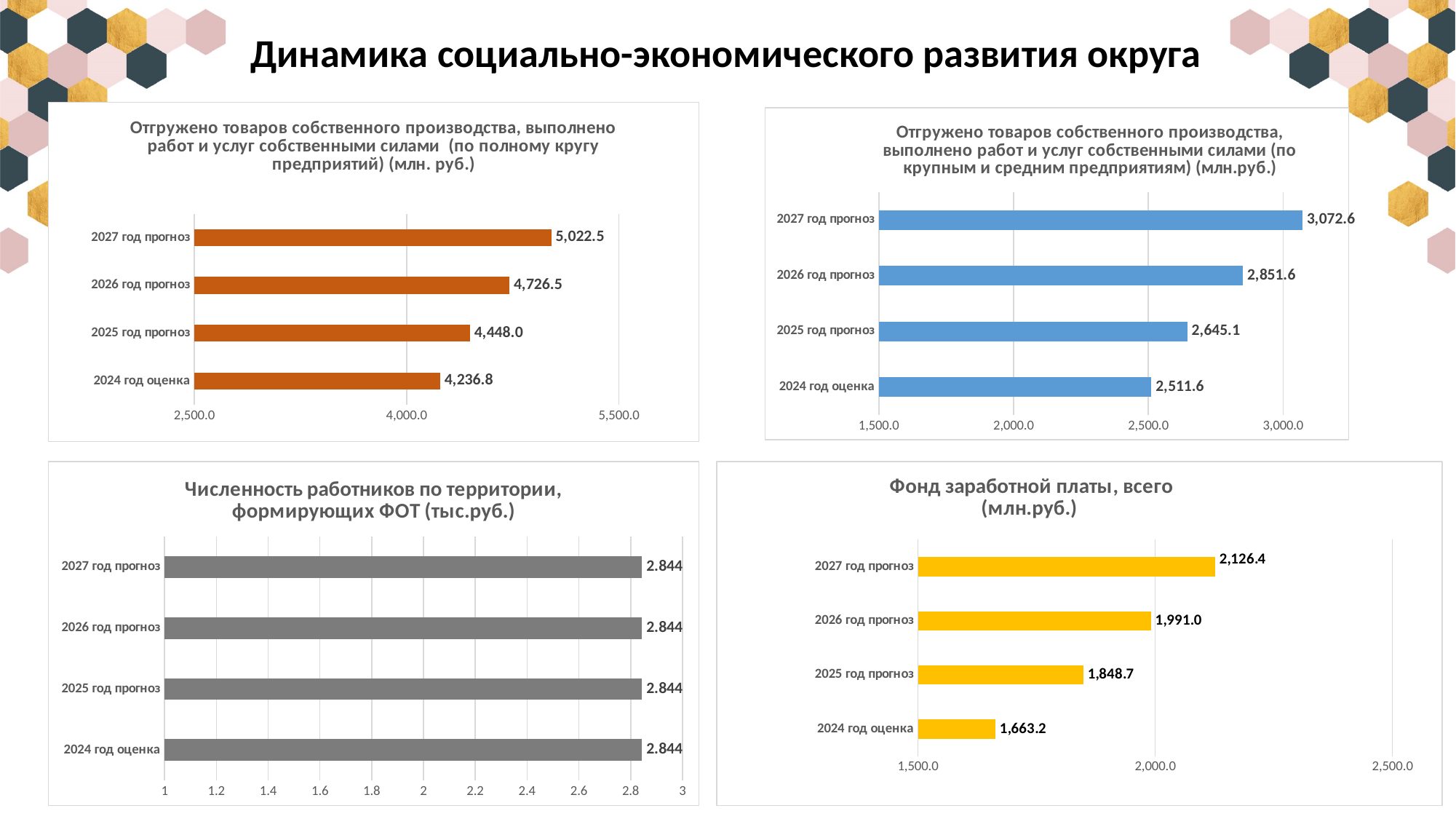
In the top-left chart (по полному кругу предприятий), what is the difference between the 2027 год прогноз and 2024 год оценка values? 785.7 In the top-right chart (по крупным и средним предприятиям), what is the value for 2025 год прогноз? 2,645.1 In the top-right chart (по крупным и средним предприятиям), what is the difference between the 2027 год прогноз and 2024 год оценка values? 561.0 In the bottom-left chart (Численность работников по территории, формирующих ФОТ), what is the value for 2026 год прогноз? 2.844 How many charts are on the slide, and what type are they? 4 bar charts In the top-left chart (по полному кругу предприятий), what is the value for 2027 год прогноз? 5,022.5 In the top-right chart (по крупным и средним предприятиям), which category has the highest value? 2027 год прогноз In the bottom-right chart (Фонд заработной платы, всего), what is the value for 2025 год прогноз? 1,848.7 In the bottom-right chart (Фонд заработной платы, всего), what is the difference between the 2027 год прогноз and 2024 год оценка values? 463.2 In the top-left chart (по полному кругу предприятий), what is the value for 2024 год оценка? 4,236.8 In the bottom-right chart (Фонд заработной платы, всего), which category has the lowest value? 2024 год оценка In the bottom-left chart (Численность работников по территории, формирующих ФОТ), do the values change across the years shown? No, all are 2.844